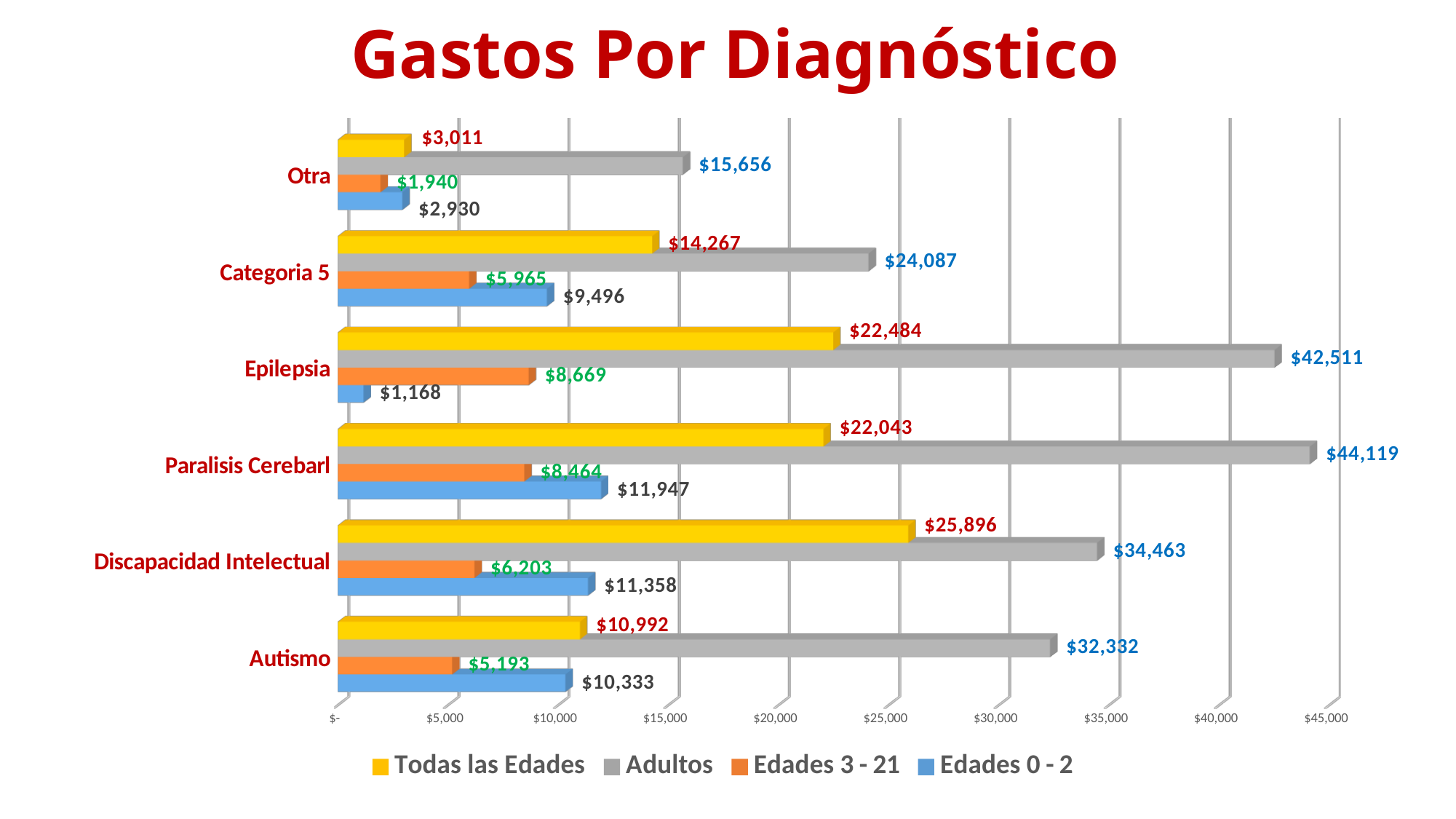
What is the Edades 3 - 21 value for Categoria 5? $5,965 What is the Edades 0 - 2 value for Autismo? $10,333 How many series does the legend list? 4 How many diagnosis categories are shown on the chart? 6 Is the Adultos value for Discapacidad Intelectual greater or less than $30,000? greater Which is larger, the Todas las Edades value for Epilepsia or for Paralisis Cerebarl? Epilepsia What kind of chart is shown on the slide? bar chart Which category has the lowest Edades 0 - 2 value? Epilepsia What is the difference between the Adultos and Todas las Edades values for Otra? $12,645 Which category has the highest Adultos value? Paralisis Cerebarl Which category has the highest Todas las Edades value? Discapacidad Intelectual What is the Adultos value for Epilepsia? $42,511